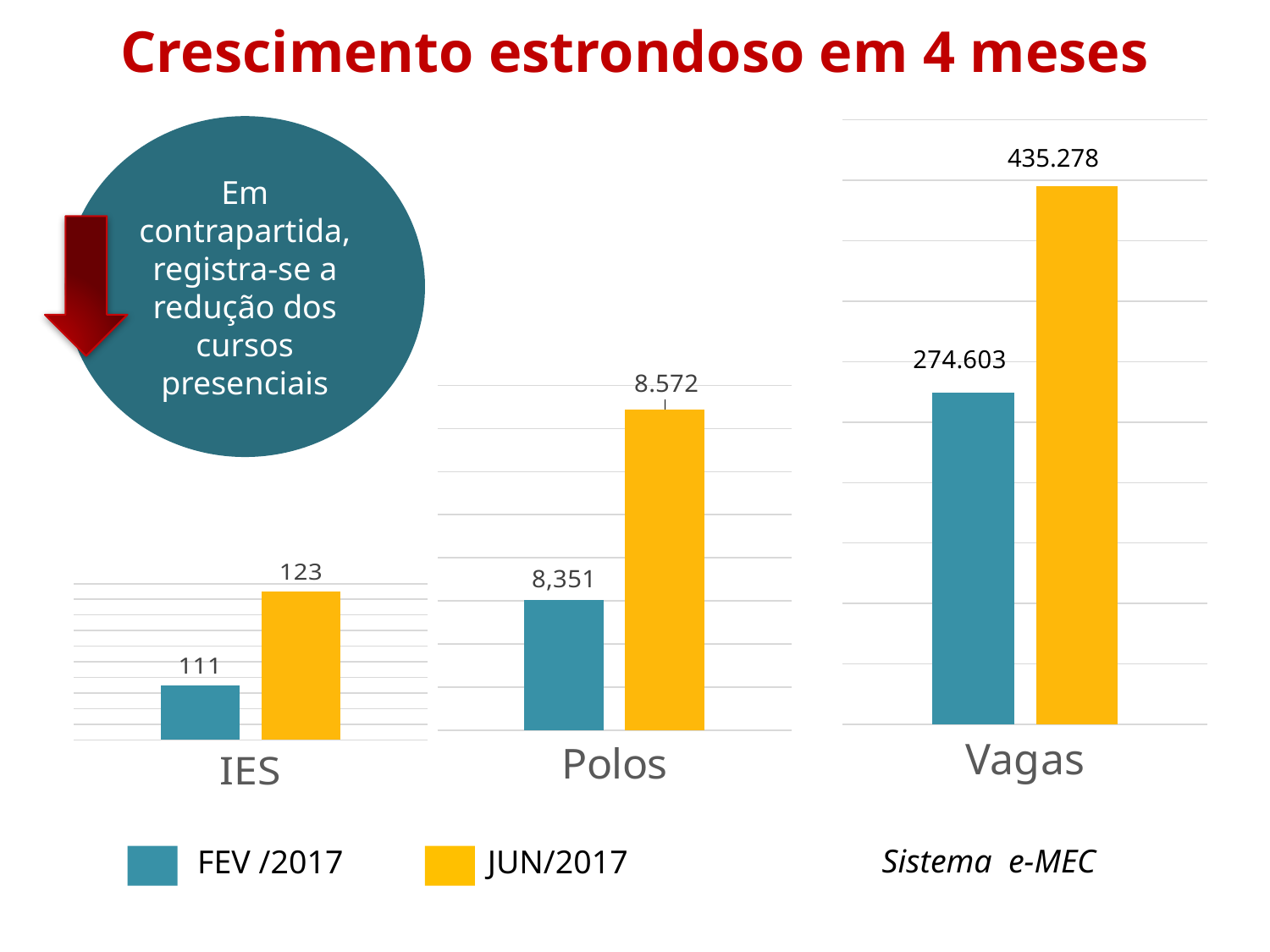
What is the title of the slide above the charts? Crescimento estrondoso em 4 meses In the Vagas chart, which series has the larger value, FEV/2017 or JUN/2017? JUN/2017 What kind of chart is the Polos chart? bar chart In the Vagas chart, what is the value for FEV/2017? 274.603 In the IES chart, what is the value for FEV/2017? 111 In the Polos chart, what is the value for FEV/2017? 8,351 In the Vagas chart, what is the difference between the JUN/2017 and FEV/2017 values? 160.675 How many series does the legend list for the charts? 2 In the IES chart, what is the value for JUN/2017? 123 In the Vagas chart, what is the value for JUN/2017? 435.278 In the Polos chart, what is the value for JUN/2017? 8.572 In the IES chart, what is the difference between the JUN/2017 and FEV/2017 values? 12